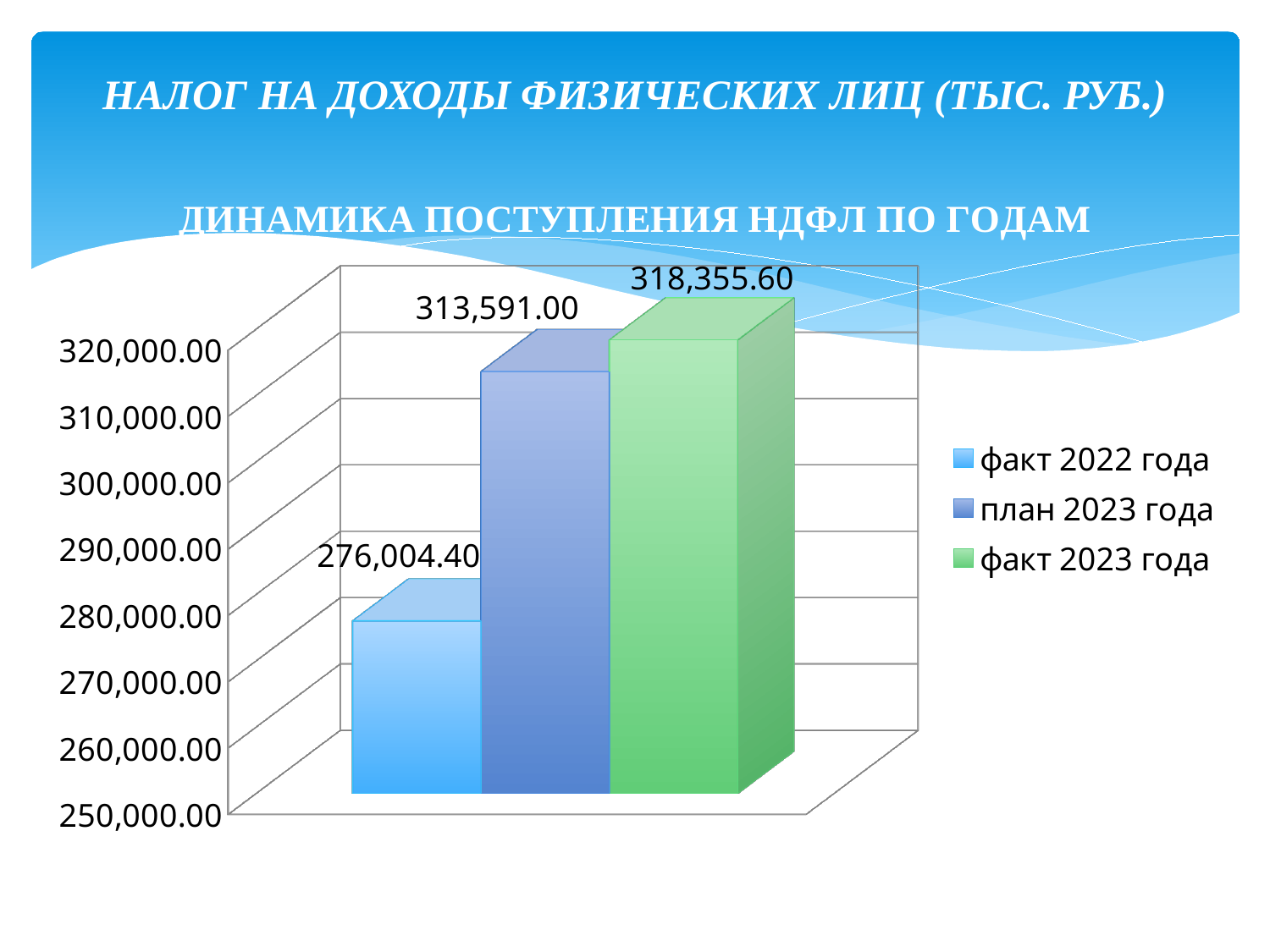
Which series has the highest value? факт 2023 года Is the value for факт 2022 года greater or less than 280,000.00? less What is the value for факт 2022 года? 276,004.40 Which series has the lowest value? факт 2022 года Which is larger, факт 2022 года or план 2023 года? план 2023 года What is the value for факт 2023 года? 318,355.60 What is the difference between план 2023 года and факт 2022 года? 37,586.60 What kind of chart is shown on the slide? bar chart What is the title of the chart? ДИНАМИКА ПОСТУПЛЕНИЯ НДФЛ ПО ГОДАМ How many series does the legend list? 3 What is the value for план 2023 года? 313,591.00 What is the difference between факт 2023 года and план 2023 года? 4,764.60